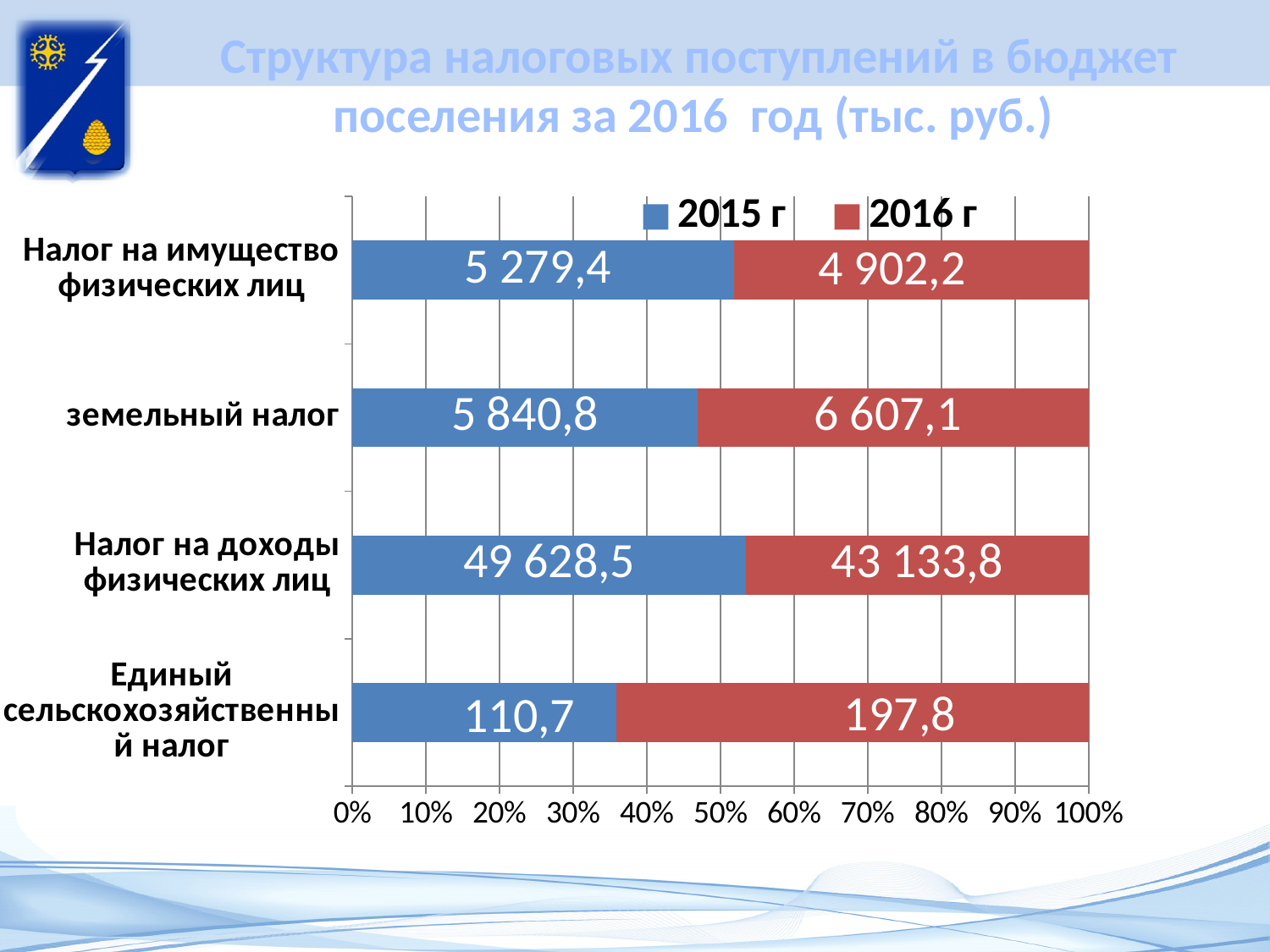
By how much did земельный налог increase from 2015 г to 2016 г? 766,3 Which category has the highest 2015 г value? Налог на доходы физических лиц Which is larger for Налог на имущество физических лиц: the 2015 г value or the 2016 г value? 2015 г What kind of chart is shown on the slide? Stacked bar chart What is the 2016 г value for Единый сельскохозяйственный налог? 197,8 How many series does the legend list? 2 Which category has the lowest 2016 г value? Единый сельскохозяйственный налог How many tax categories are shown in the chart? 4 What is the 2016 г value for Налог на доходы физических лиц? 43 133,8 What is the 2015 г value for земельный налог? 5 840,8 What is the total of the 2015 г and 2016 г values for Единый сельскохозяйственный налог? 308,5 Is the 2015 г share of the bar for Единый сельскохозяйственный налог greater or less than 40%? less